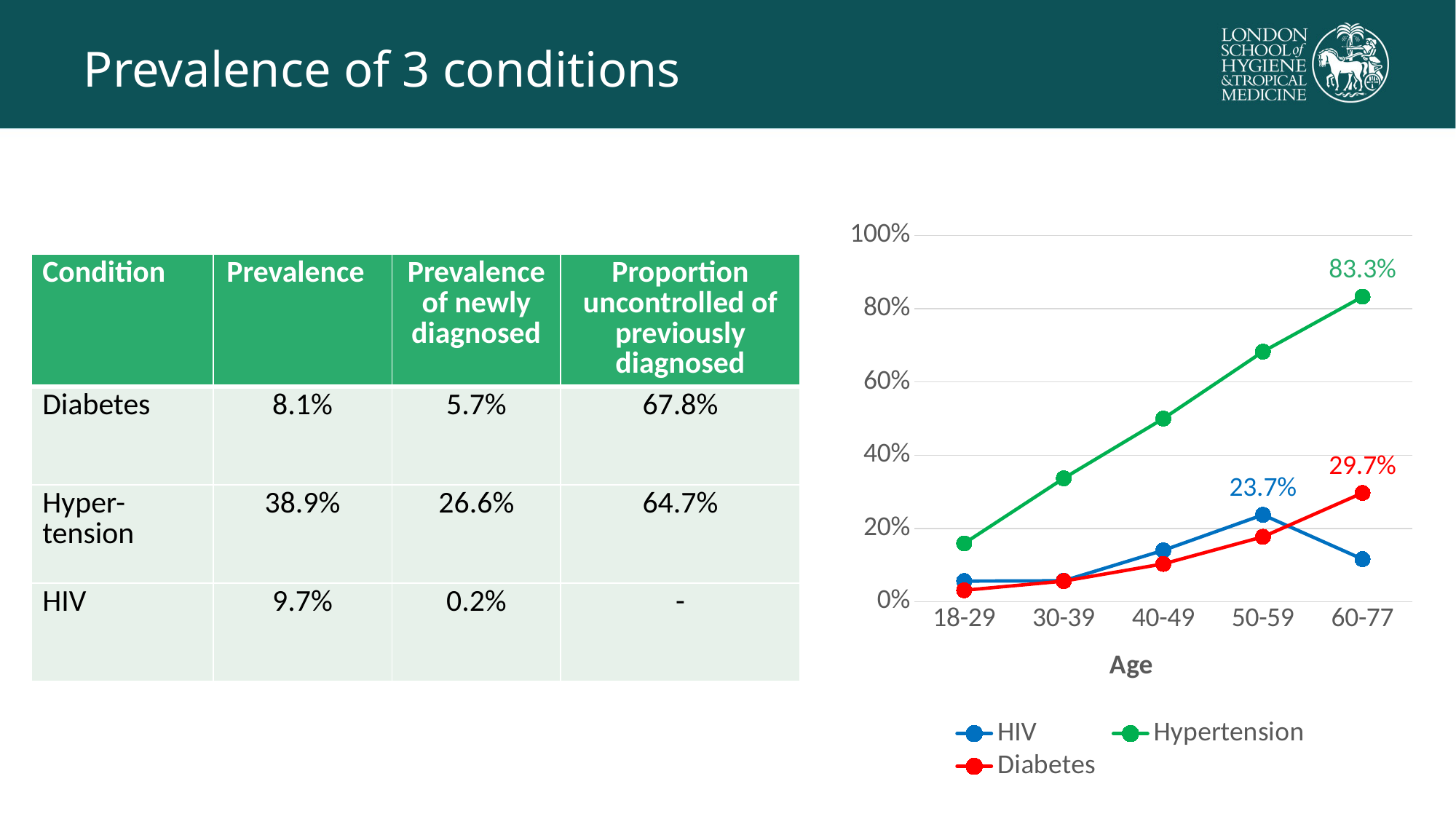
How many series does the chart legend list? 3 Which series has the larger value at the 60-77 age group, Hypertension or Diabetes? Hypertension What is the HIV value for the 50-59 age group? 23.7% What is the Hypertension value for the 60-77 age group? 83.3% Is the HIV value for the 60-77 age group greater or less than 20%? less What is the Diabetes value for the 60-77 age group? 29.7% How many age groups are shown on the x axis of the chart? 5 Which age group has the highest Hypertension value? 60-77 What type of chart is shown on the right of the slide? Line chart Which age group has the lowest Hypertension value? 18-29 Is the Hypertension value for the 40-49 age group greater or less than 40%? greater Does the Hypertension line rise or fall across the age groups from 18-29 to 60-77? Rises